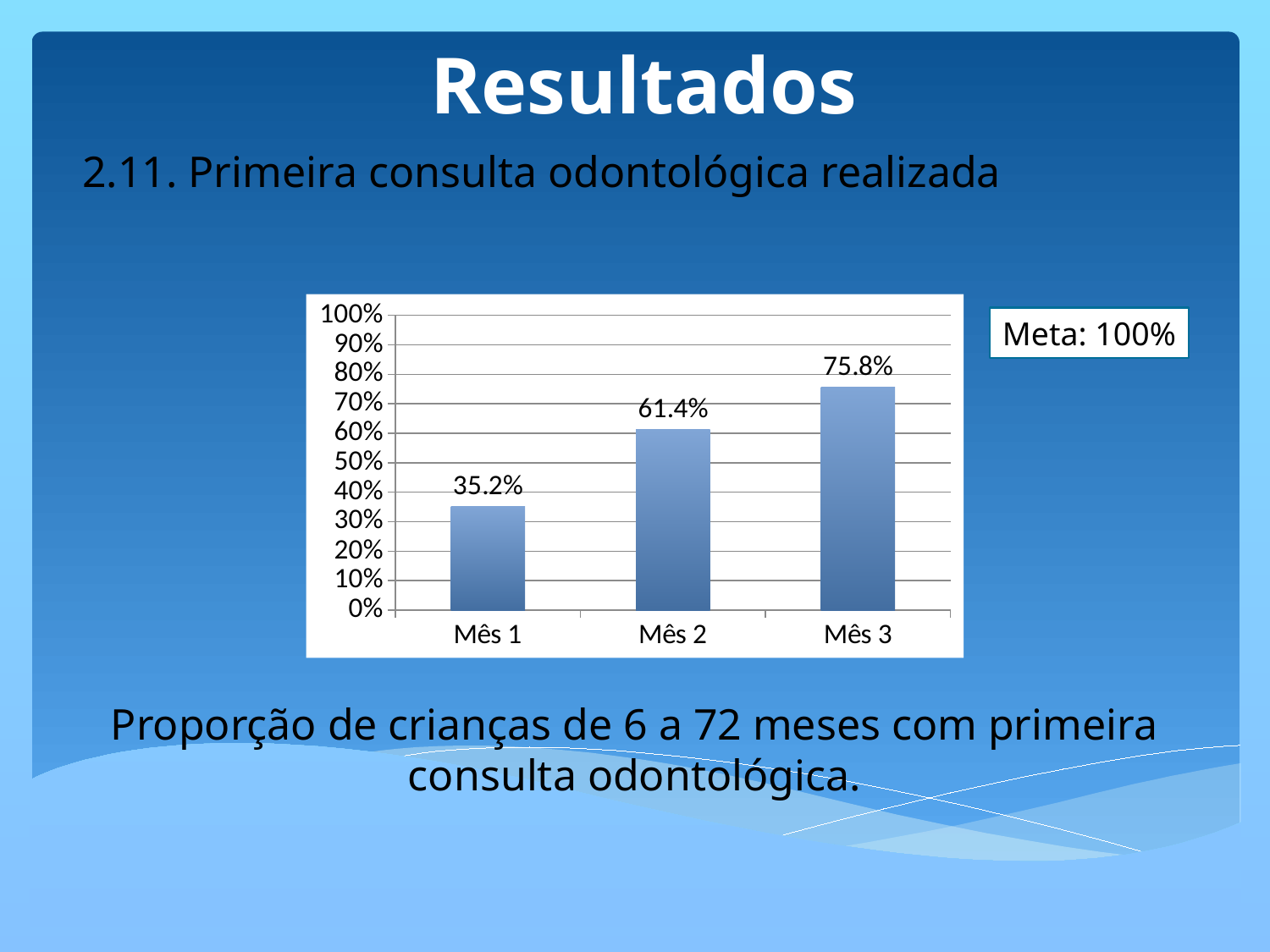
Which month has the lowest value? Mês 1 Which is larger, the value for Mês 2 or the value for Mês 3? Mês 3 How many months are shown on the chart? 3 What is the difference between the values for Mês 3 and Mês 1? 40.6% What kind of chart is shown on the slide? bar chart Do the values rise or fall from Mês 1 to Mês 3? rise What is the difference between the values for Mês 2 and Mês 1? 26.2% What is the value for Mês 1? 35.2% What is the value for Mês 2? 61.4% What is the value for Mês 3? 75.8% Which month has the highest value? Mês 3 Is the value for Mês 1 greater or less than 40%? less